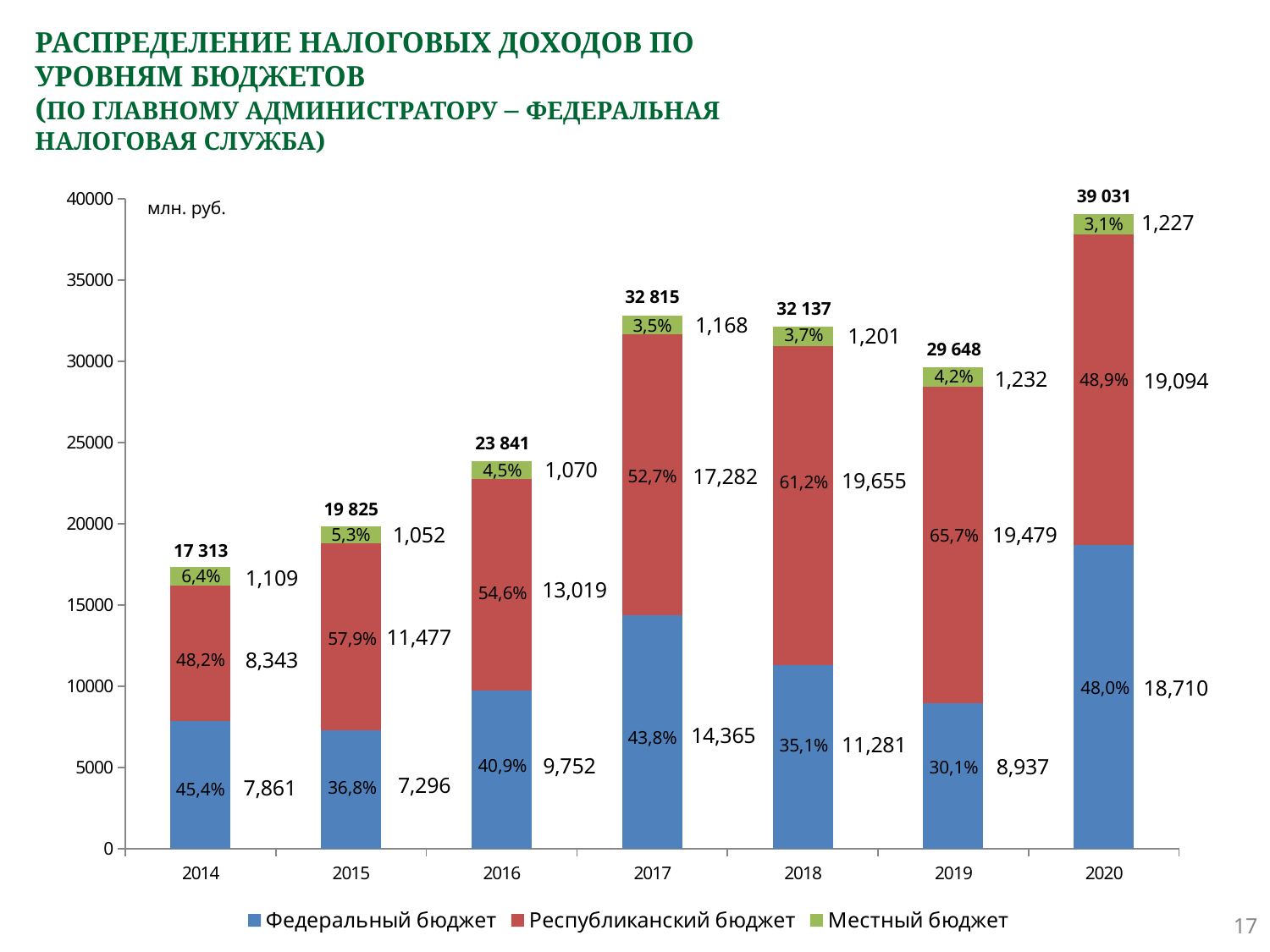
Which is larger: the Федеральный бюджет value in 2020 or in 2019? 2020 Which year has the lowest total tax revenue? 2014 What is the value for Федеральный бюджет in 2017? 14,365 What is the value for Местный бюджет in 2014? 1,109 How many years are shown on the x axis? 7 Which year has the highest total tax revenue? 2020 What is the unit of measurement shown on the chart? млн. руб. What is the total tax revenue shown above the bar for 2020? 39 031 What type of chart is shown on the slide? Stacked bar chart How many series does the legend list? 3 What is the value for Республиканский бюджет in 2018? 19,655 What percentage share does Республиканский бюджет have in 2019? 65,7%